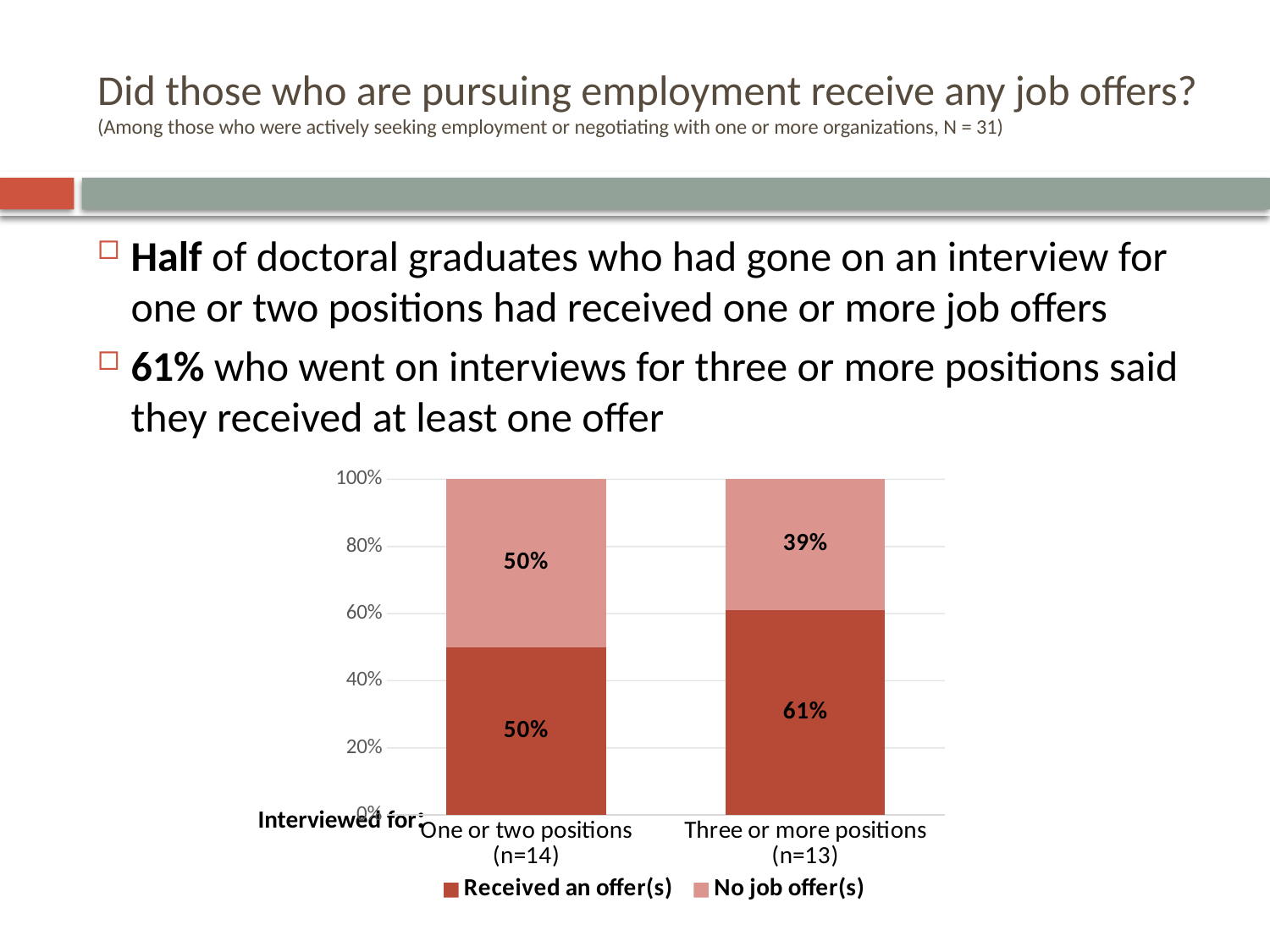
Is the 'Received an offer(s)' value for three or more positions greater or less than 60%? greater What percentage of those who interviewed for one or two positions received an offer(s)? 50% What percentage of those who interviewed for one or two positions had no job offer(s)? 50% Which category has the higher share of 'Received an offer(s)'? Three or more positions What percentage of those who interviewed for three or more positions received an offer(s)? 61% What kind of chart is shown on the slide? Stacked bar chart How many categories are shown on the x axis? 2 Which category has the lower share of 'No job offer(s)'? Three or more positions What is the difference in the 'Received an offer(s)' percentage between three or more positions and one or two positions? 11% What percentage of those who interviewed for three or more positions had no job offer(s)? 39% How many series does the legend list? 2 What is the sample size (n) for the 'Three or more positions' category? 13